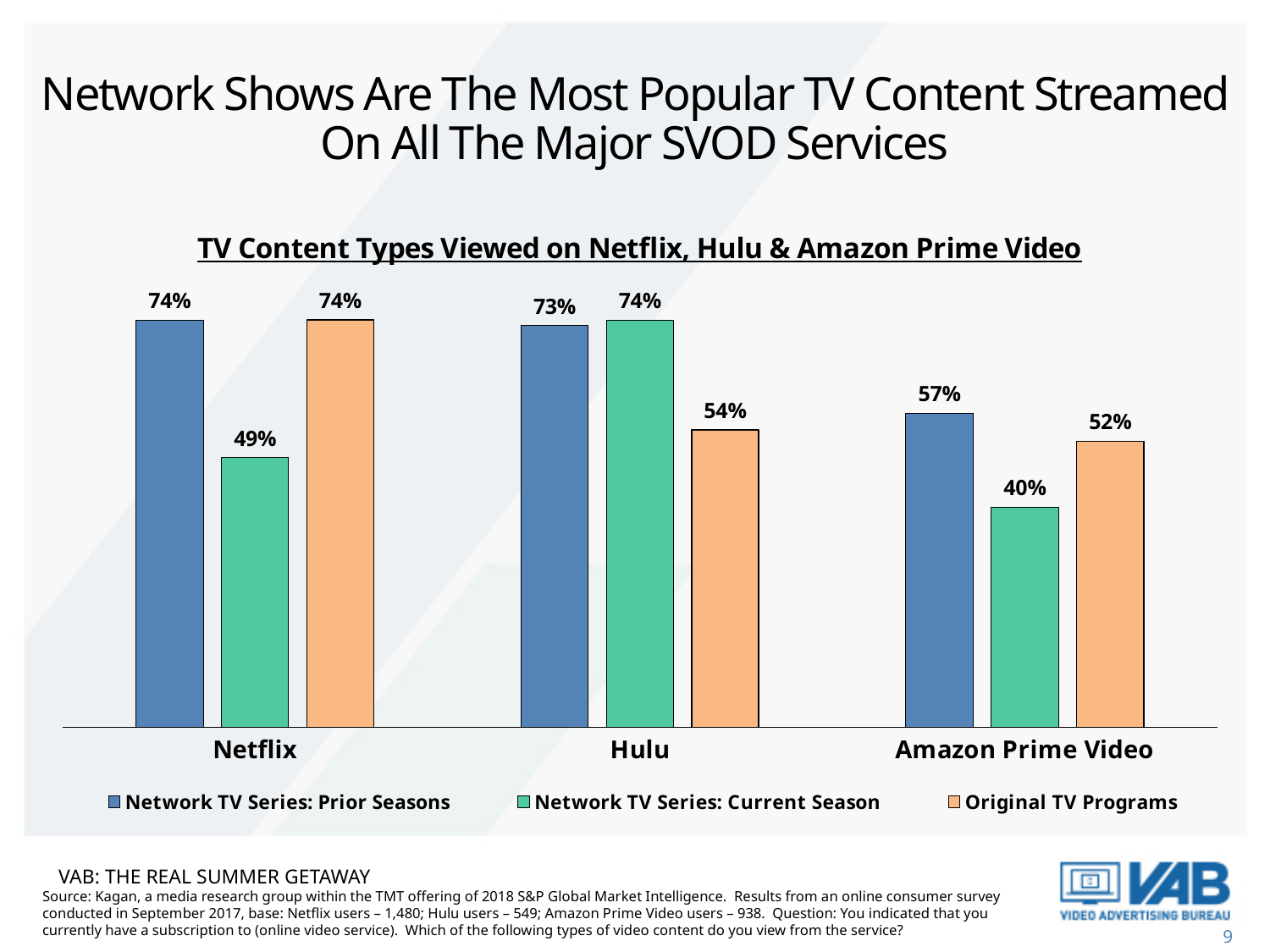
What type of chart is shown on the slide? Bar chart What is the title of the chart? TV Content Types Viewed on Netflix, Hulu & Amazon Prime Video Which service has the highest value for Original TV Programs? Netflix How many services are shown on the x axis? 3 What is the difference between the Original TV Programs values for Netflix and Hulu? 20% What percentage of Hulu users view Original TV Programs? 54% Which is larger for Hulu: Network TV Series: Current Season or Original TV Programs? Network TV Series: Current Season What percentage of Netflix users view Network TV Series: Current Season? 49% Which service has the lowest value for Network TV Series: Current Season? Amazon Prime Video What percentage of Amazon Prime Video users view Network TV Series: Prior Seasons? 57% How many series does the legend list? 3 What is the difference between Network TV Series: Prior Seasons and Network TV Series: Current Season for Amazon Prime Video? 17%